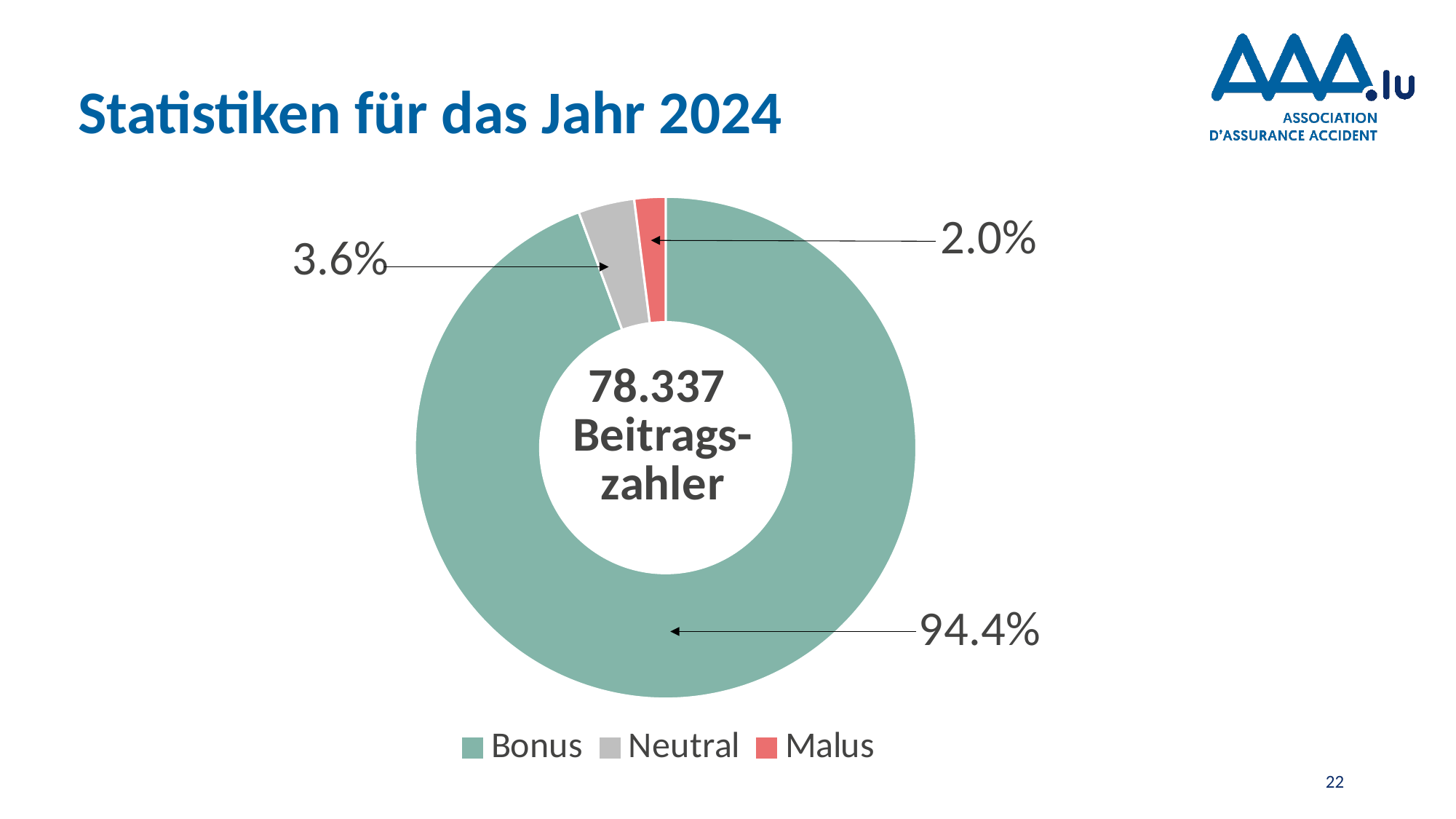
Which colour represents Malus in the legend? Red Which slice is larger, Neutral or Malus? Neutral How many categories does the chart show? 3 What share of the donut chart is Bonus? 94.4% What is the difference in percentage points between the Bonus and Neutral slices? 90.8 Which category has the smallest slice in the chart? Malus What kind of chart is shown on the slide? Donut (pie) chart What number of Beitragszahler is shown in the centre of the chart? 78.337 What share of the donut chart is Neutral? 3.6% What share of the donut chart is Malus? 2.0% What is the difference in percentage points between the Neutral and Malus slices? 1.6 Which category has the largest slice in the chart? Bonus